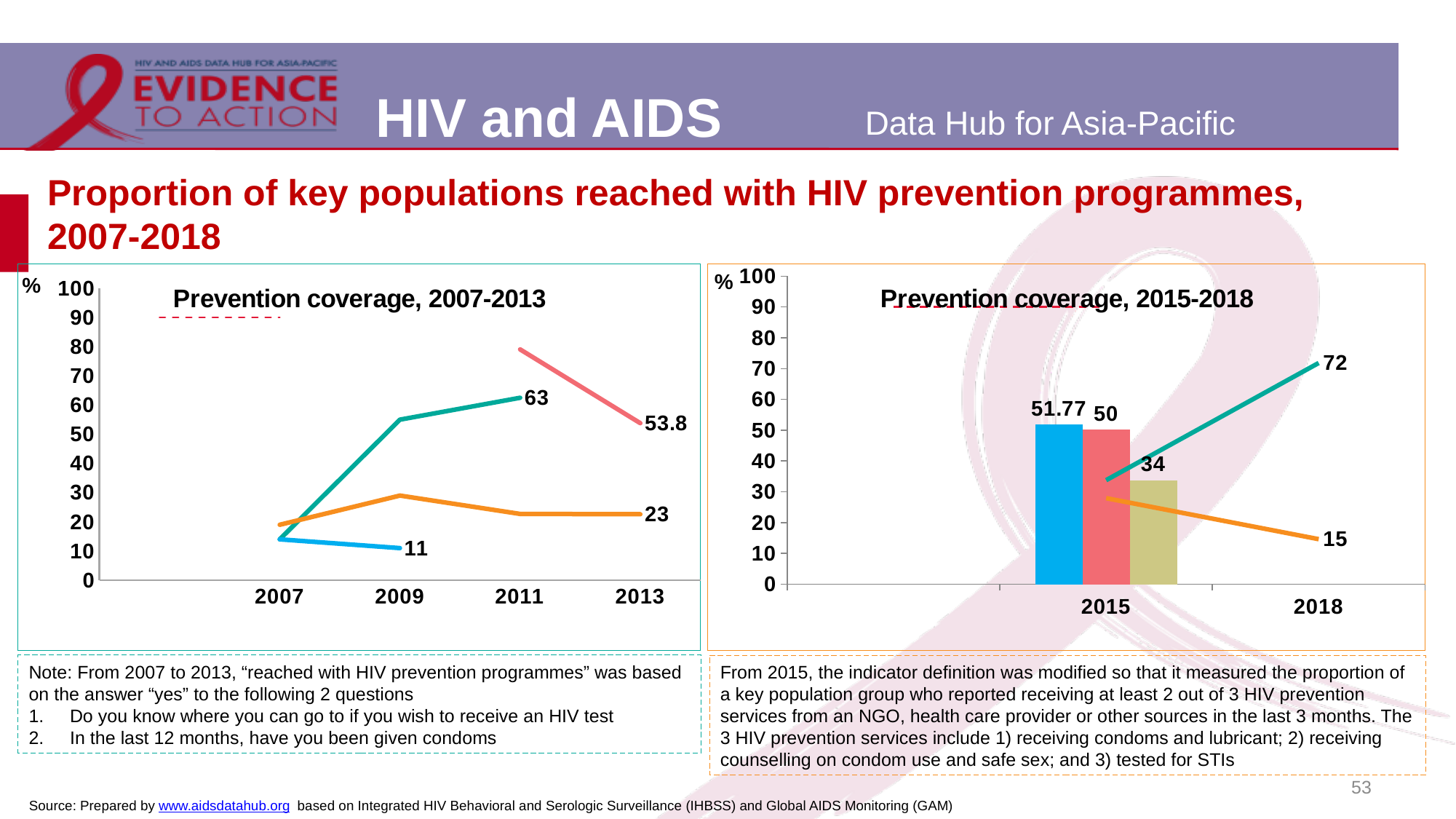
In the 'Prevention coverage, 2007-2013' chart, what value is labelled on the orange line at 2013? 23 In the 'Prevention coverage, 2007-2013' chart, how many years are shown on the x axis? 4 In the 'Prevention coverage, 2007-2013' chart, what value is labelled on the green line at 2011? 63 In the 'Prevention coverage, 2007-2013' chart, what value is labelled on the red line at 2013? 53.8 In the 'Prevention coverage, 2007-2013' chart, does the red line rise or fall from 2011 to 2013? fall In the 'Prevention coverage, 2007-2013' chart, what value is labelled on the blue line at 2009? 11 In the 'Prevention coverage, 2015-2018' chart, what value is labelled on the green line at 2018? 72 In the 'Prevention coverage, 2007-2013' chart, is the value of the red line at 2011 greater or less than 70? greater What kind of chart is the 'Prevention coverage, 2007-2013' chart on the left? line chart In the 'Prevention coverage, 2015-2018' chart, what is the difference between the blue bar (51.77) and the red bar (50) at 2015? 1.77 In the 'Prevention coverage, 2015-2018' chart, does the orange line rise or fall from 2015 to 2018? fall In the 'Prevention coverage, 2015-2018' chart, what is the value of the blue bar at 2015? 51.77